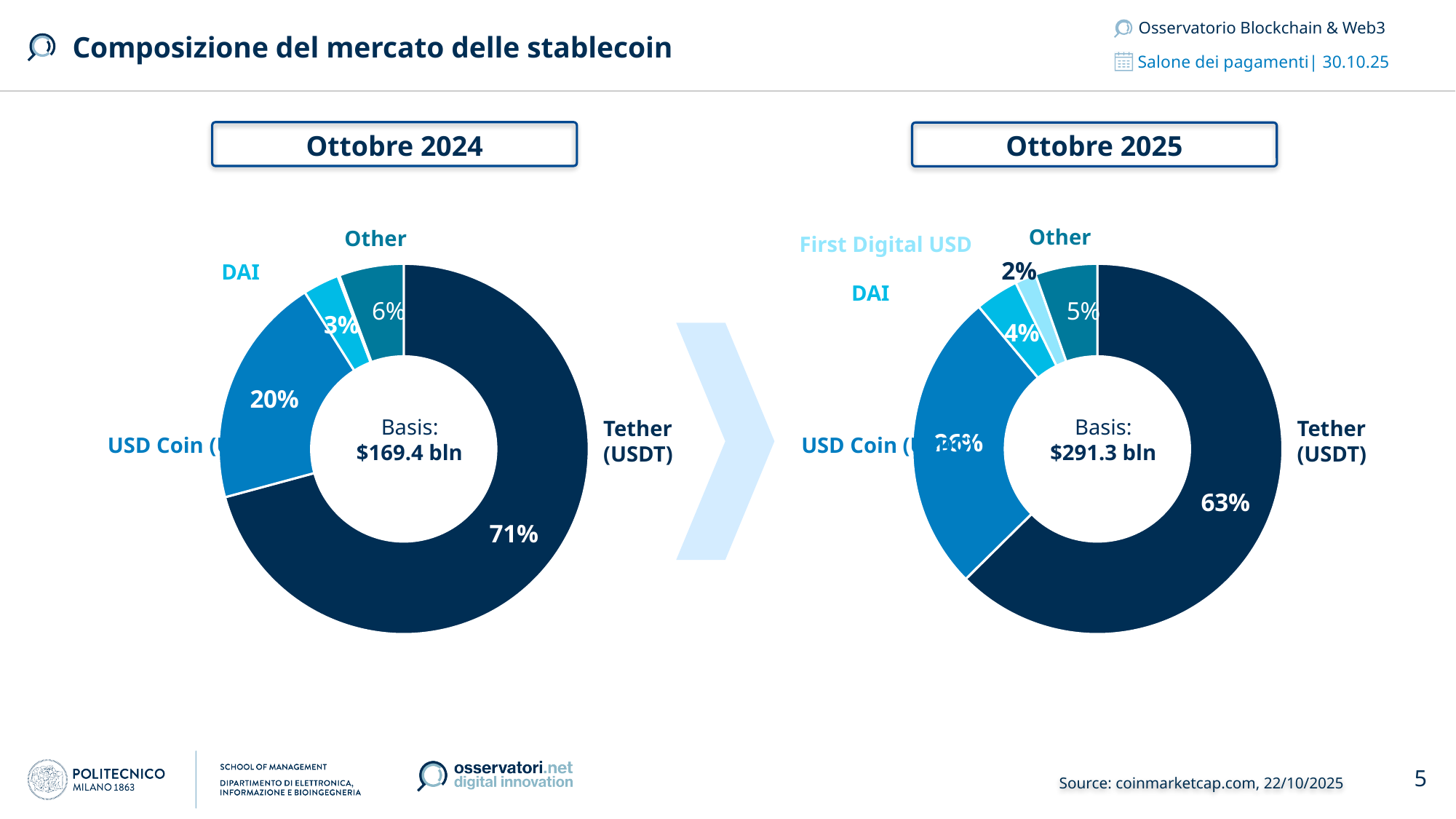
In the Ottobre 2025 chart, what is the share for Other? 5% In the Ottobre 2024 chart, what share of the stablecoin market does Tether (USDT) hold? 71% In the Ottobre 2025 chart, what share does Tether (USDT) hold? 63% How many categories are shown in the Ottobre 2025 chart? 5 What is the Basis value shown in the centre of the Ottobre 2025 chart? $291.3 bln In the Ottobre 2024 chart, which category has the largest share? Tether (USDT) What kind of chart is used on this slide? Donut (pie) chart By how many percentage points did Tether (USDT)'s share fall from the Ottobre 2024 chart to the Ottobre 2025 chart? 8 percentage points In the Ottobre 2025 chart, what is the share for First Digital USD? 2% In the Ottobre 2024 chart, what is the share for DAI? 3% In the Ottobre 2025 chart, which category has the smallest share? First Digital USD In the Ottobre 2024 chart, what is the share for USD Coin? 20%